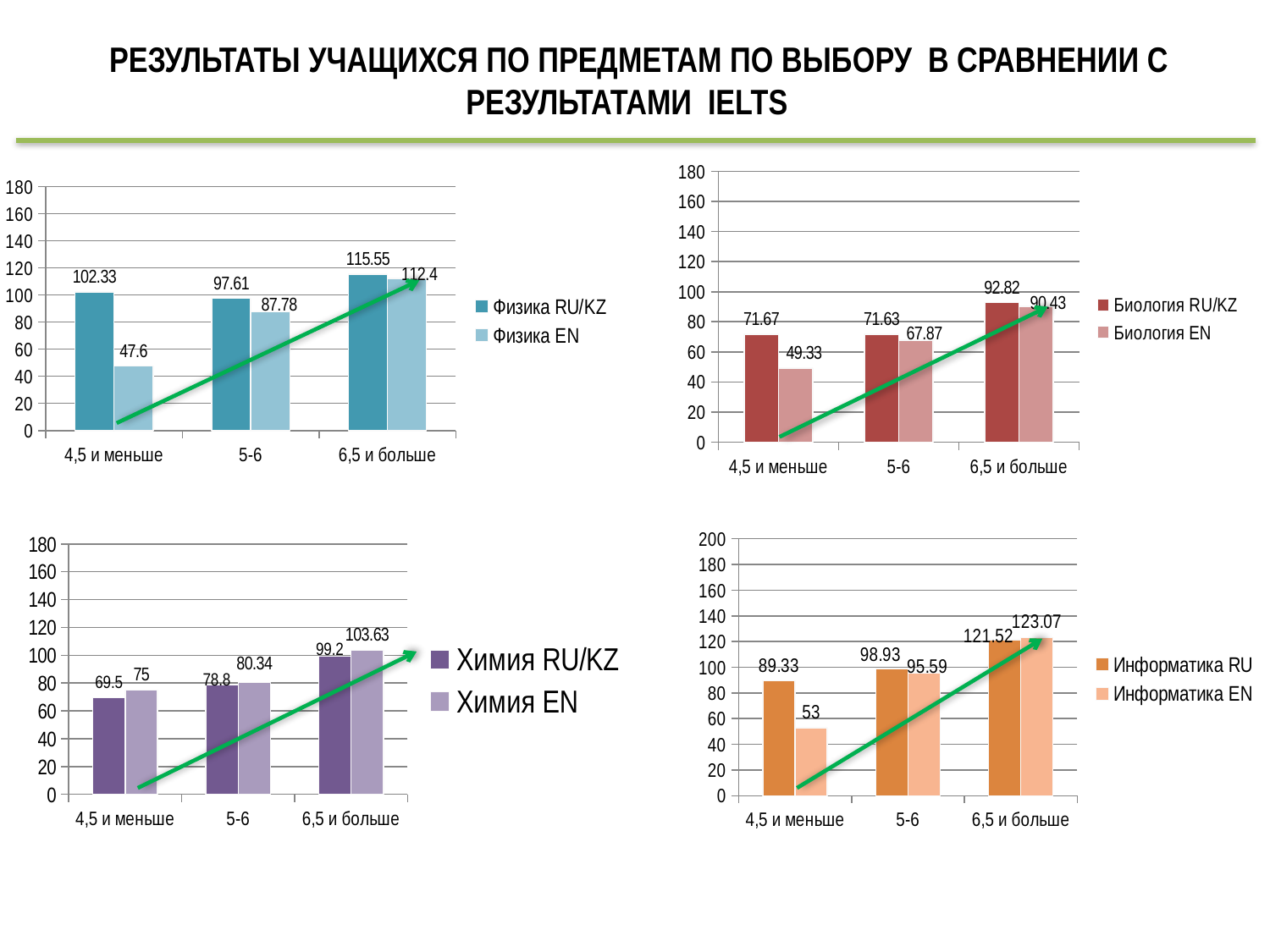
In the top-left chart (Физика), what is the value of Физика EN for the category 4,5 и меньше? 47.6 In the bottom-left chart (Химия), what is the difference between Химия EN and Химия RU/KZ for 6,5 и больше? 4.43 In the bottom-right chart (Информатика), what is the value of Информатика EN for 4,5 и меньше? 53 In the top-left chart (Физика), what is the value of Физика RU/KZ for 6,5 и больше? 115.55 How many series does the legend of the top-left chart (Физика) list? 2 In the top-right chart (Биология), which category has the highest Биология RU/KZ value? 6,5 и больше In the bottom-left chart (Химия), what is the value of Химия RU/KZ for 4,5 и меньше? 69.5 In the top-right chart (Биология), what is the value of Биология EN for 5-6? 67.87 In the bottom-right chart (Информатика), which is larger for 5-6: Информатика RU or Информатика EN? Информатика RU In the bottom-right chart (Информатика), what is the difference between Информатика RU and Информатика EN for 4,5 и меньше? 36.33 In the top-left chart (Физика), do the Физика EN values rise or fall from 4,5 и меньше to 6,5 и больше? rise What type of chart is the bottom-left chart (Химия)? bar chart